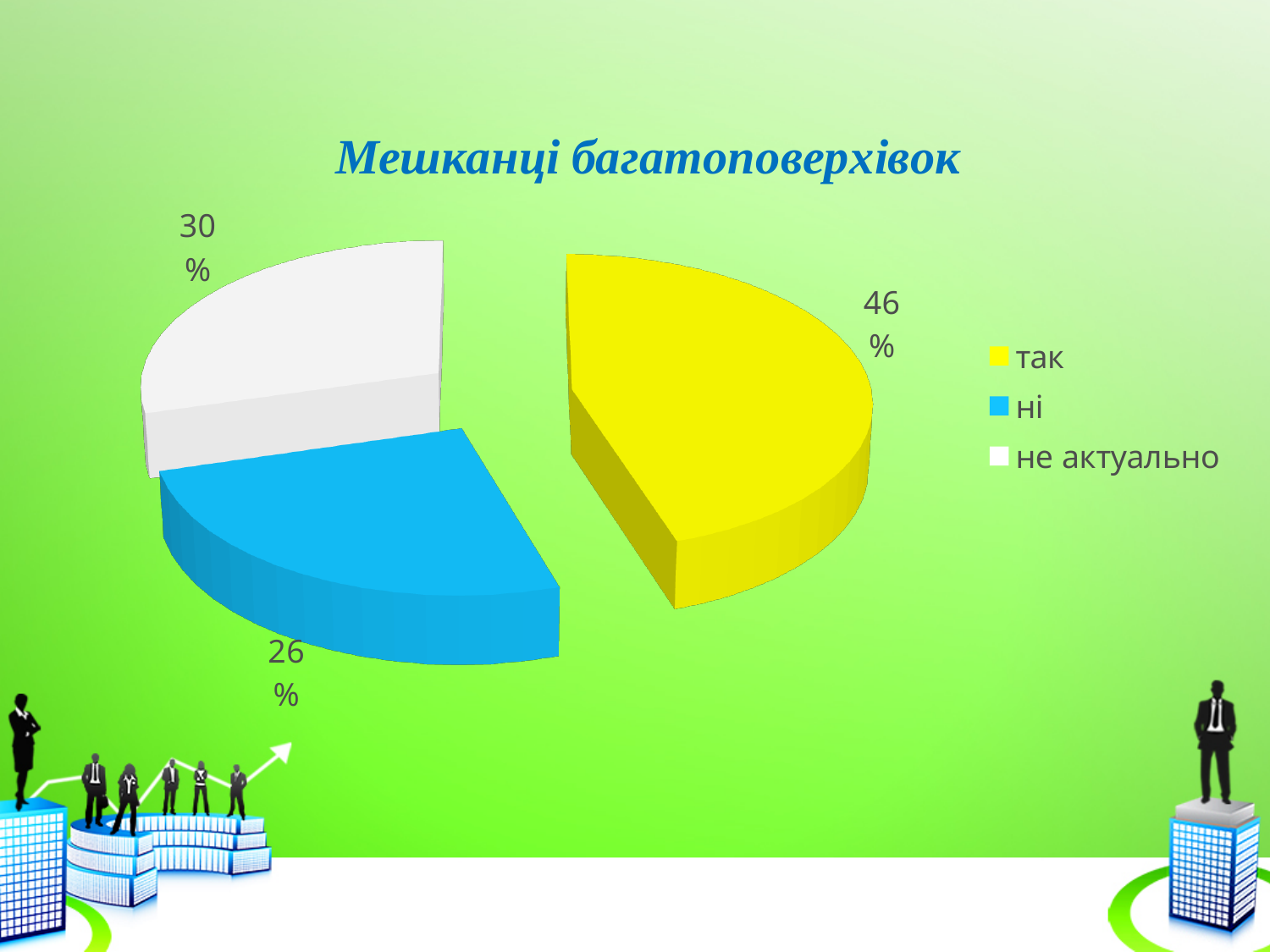
Which category has the largest share of the pie? так What percentage is shown for the "так" slice? 46% What colour is the "так" slice? yellow Which is larger, the share for "не актуально" or the share for "ні"? не актуально Which category has the smallest share of the pie? ні What is the difference in percentage points between the "так" and "ні" slices? 20 How many slices does the pie chart have? 3 What type of chart is shown on the slide? pie chart How many entries does the legend list? 3 What is the title of the chart? Мешканці багатоповерхівок What percentage is shown for the "не актуально" slice? 30% What percentage is shown for the "ні" slice? 26%